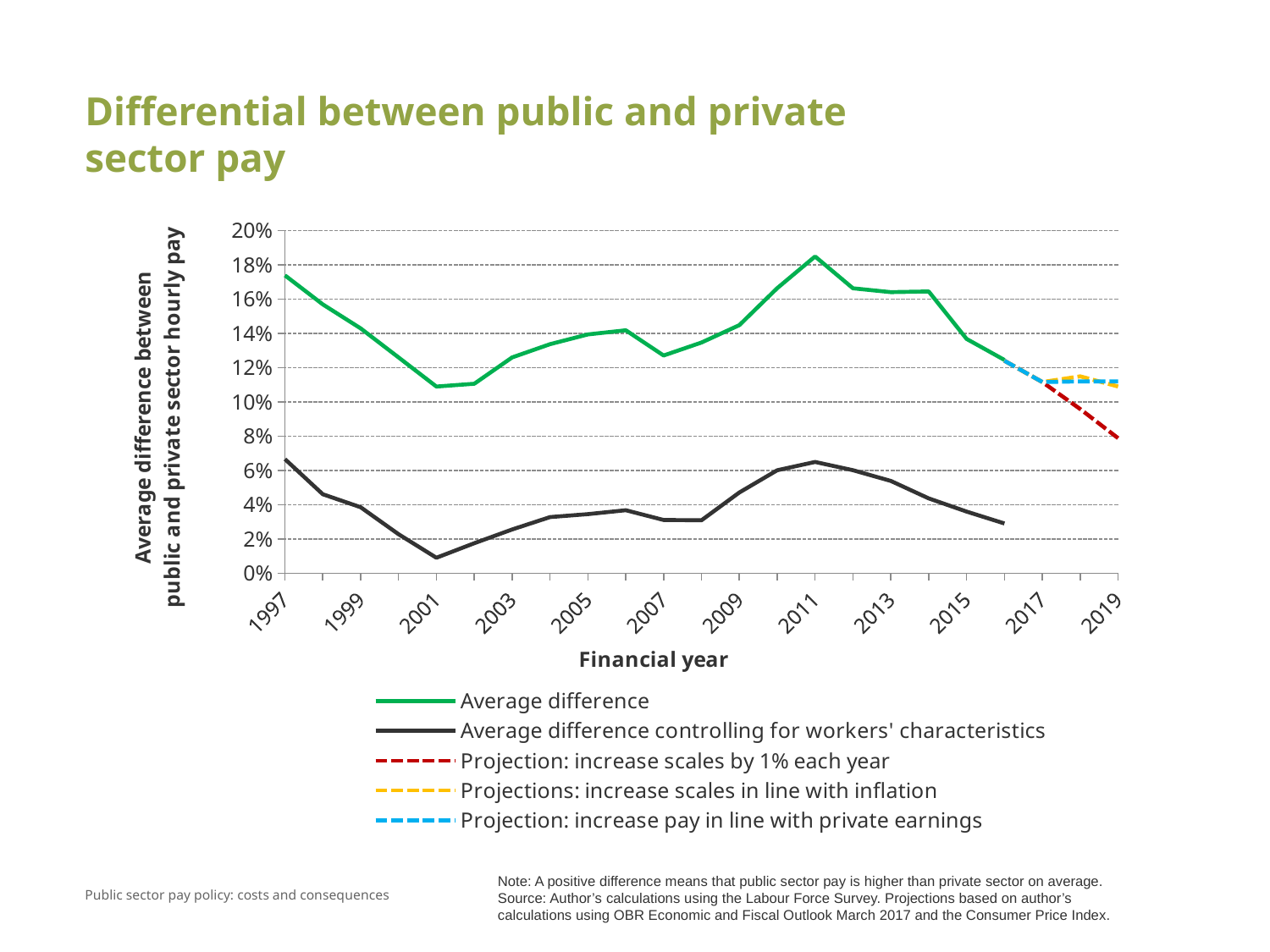
Is the Average difference value for 2001 greater or less than 12%? less How many series does the legend list? 5 In which year does the Average difference series reach its lowest value? 2001 What is the title of the x axis? Financial year What kind of chart is shown on the slide? line chart Is the value for 2001 in the Average difference controlling for workers' characteristics series greater or less than 2%? less In which year does the Average difference controlling for workers' characteristics series reach its lowest value? 2001 Is the 2019 value of the Projection: increase scales by 1% each year series greater or less than 10%? less Does the Average difference series rise or fall between 2007 and 2011? rise Which is larger for the Average difference series: the value in 1999 or the value in 2001? 1999 In which year does the Average difference series reach its highest value? 2011